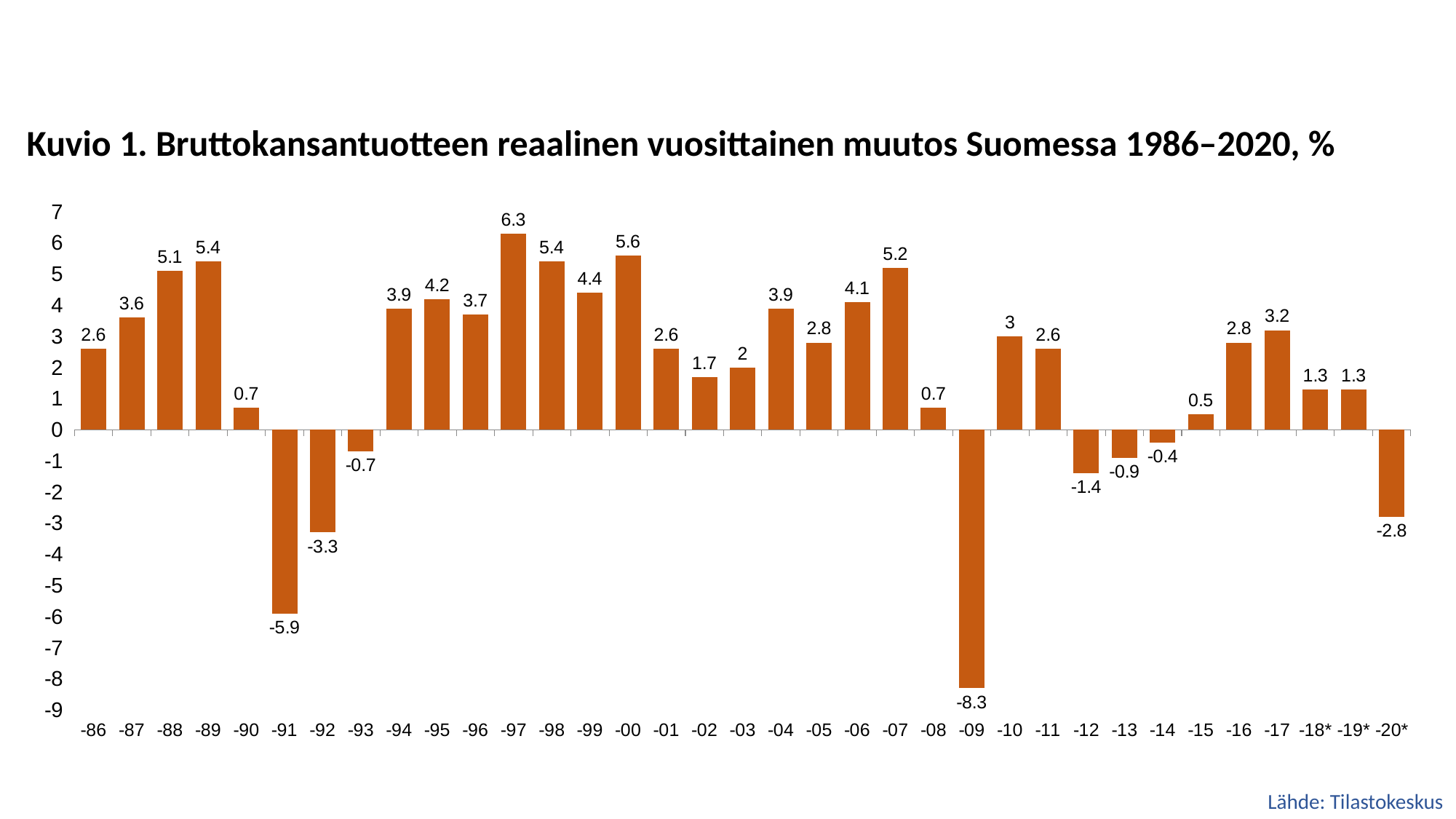
Which year has the highest value? -97 What kind of chart is shown on the slide? Bar chart Which year has the lowest value? -09 What is the value for -09? -8.3 What is the value for -91? -5.9 How many bars are shown in the chart? 35 What is the value for -97? 6.3 What is the value for -20*? -2.8 Which is larger, the value for -88 or the value for -89? -89 What is the difference between the values for -97 and -98? 0.9 What is the title of the chart? Kuvio 1. Bruttokansantuotteen reaalinen vuosittainen muutos Suomessa 1986–2020, %